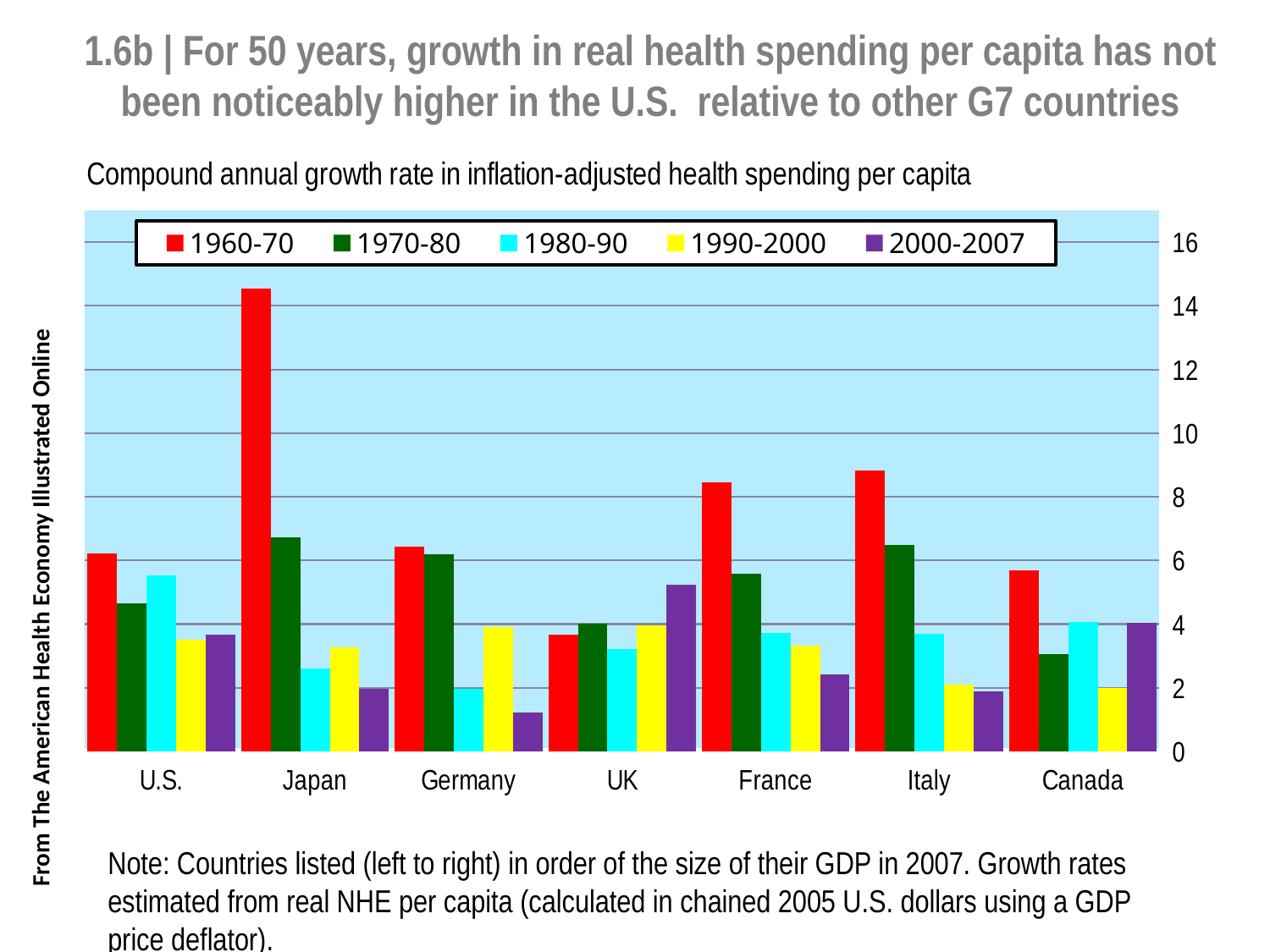
How many countries are shown on the x axis? 7 Is the 1960-70 value for Japan greater or less than 14? greater Is the 1970-80 value for Japan greater or less than 6? greater For the UK, which period has the highest bar? 2000-2007 What kind of chart is shown on the slide? bar chart How many series does the legend list? 5 Is the 2000-2007 value for Germany greater or less than 2? less What colour represents the 1960-70 series in the legend? red Which country has the lowest 2000-2007 bar? Germany For the UK, which is larger: the 1960-70 value or the 2000-2007 value? 2000-2007 Which country has the highest 1960-70 bar? Japan